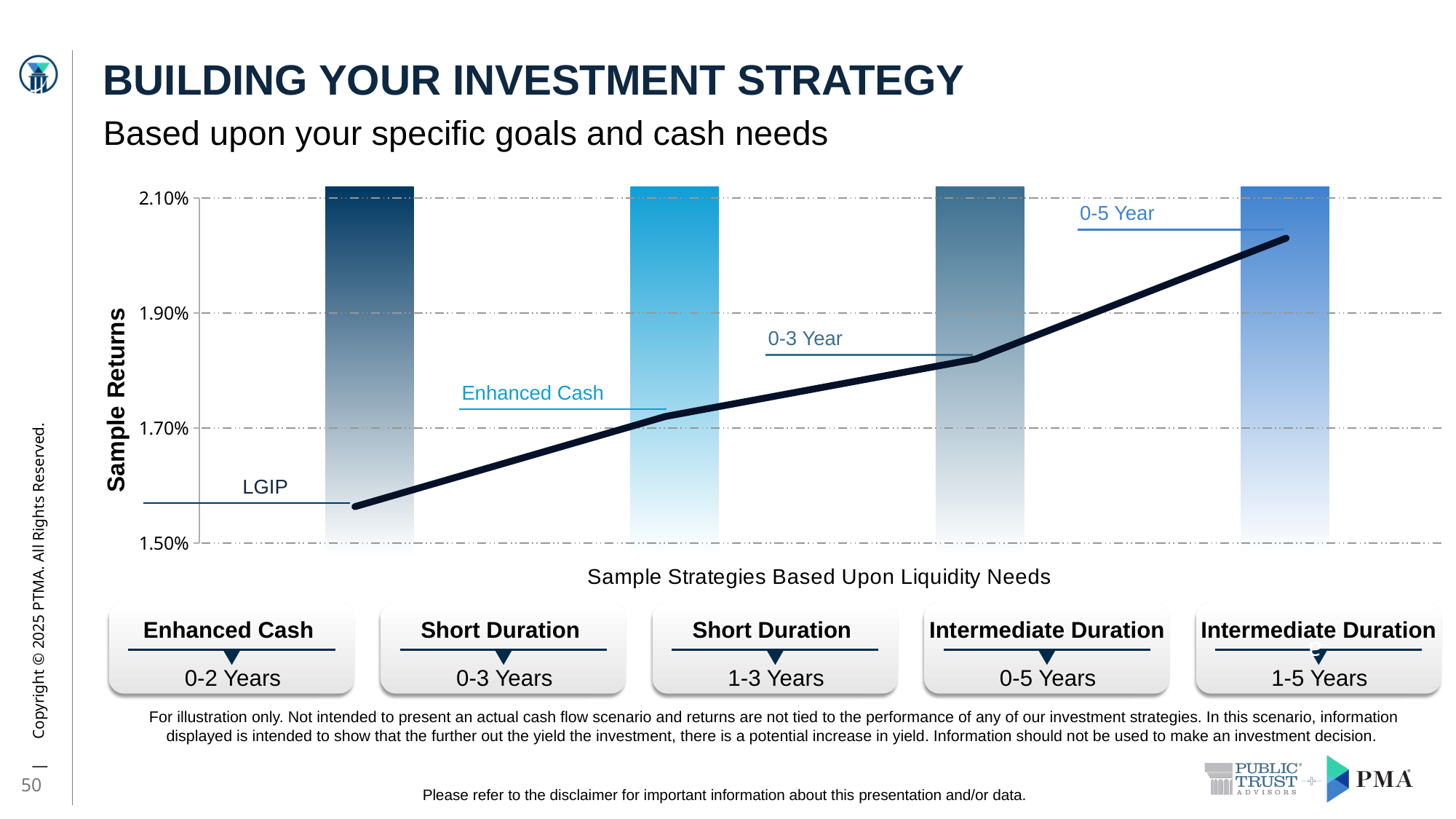
Which has the larger sample return, LGIP or 0-5 Year? 0-5 Year How many labelled points are plotted on the line? 4 Which strategy has the highest sample return on the chart? 0-5 Year What is the title of the horizontal axis of the chart? Sample Strategies Based Upon Liquidity Needs Is the value for LGIP greater or less than 1.70%? less Which has the larger sample return, Enhanced Cash or 0-3 Year? 0-3 Year What kind of chart is shown on the slide? line chart Is the value for 0-5 Year greater or less than 1.90%? greater Which strategy has the lowest sample return on the chart? LGIP What is the title of the vertical axis of the chart? Sample Returns Is the value for 0-3 Year greater or less than 1.90%? less Do the sample returns rise or fall moving from LGIP to 0-5 Year along the x axis? rise